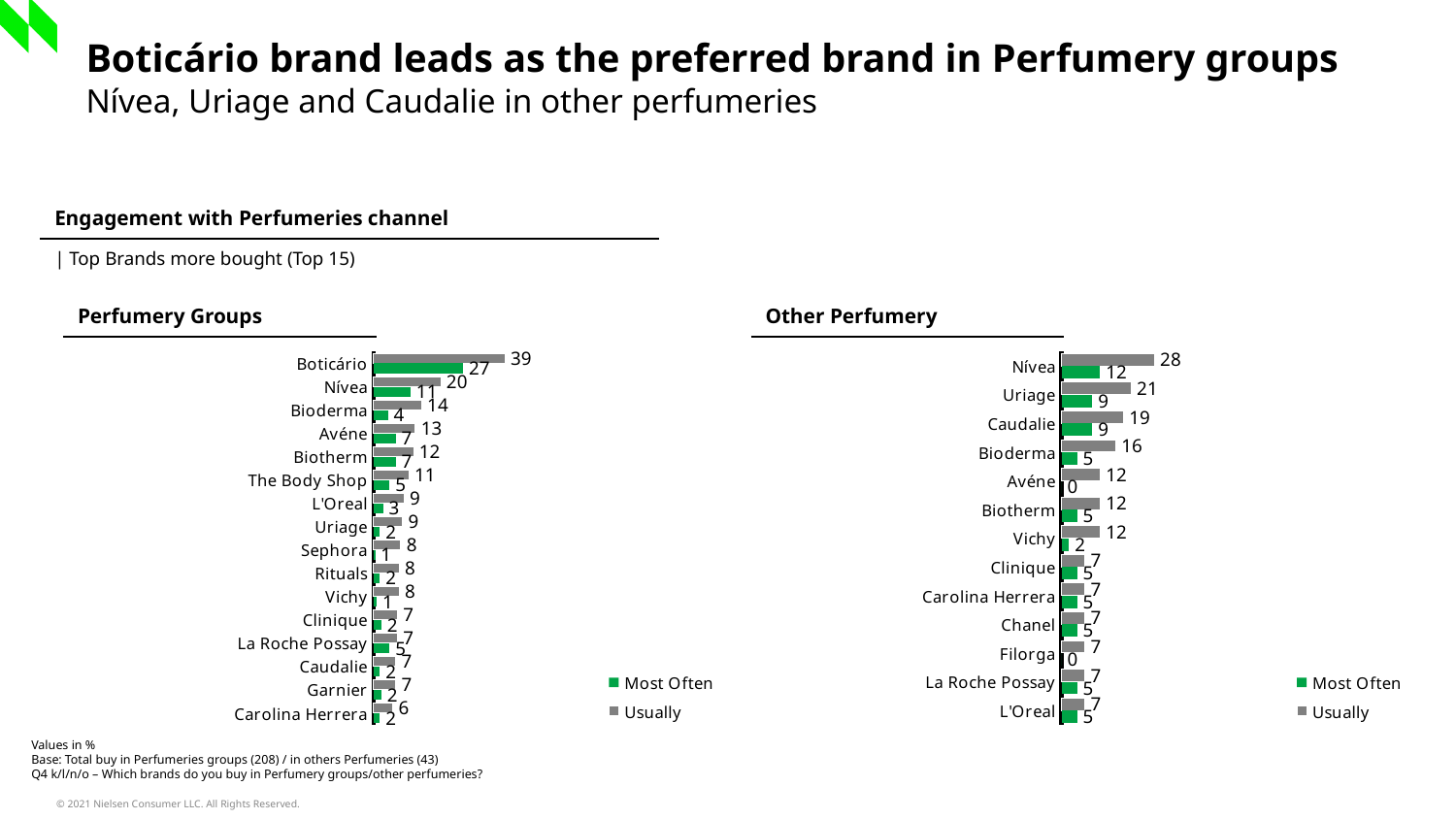
In the Perfumery Groups chart, what is the Usually value for Boticário? 39 In the Perfumery Groups chart, what is the difference between the Usually and Most Often values for Boticário? 12 In the Other Perfumery chart, what is the Usually value for Uriage? 21 In the Other Perfumery chart, what is the difference between the Usually values for Nívea and Caudalie? 9 In the Other Perfumery chart, which brand has the highest Usually value? Nívea In the Perfumery Groups chart, which brand has the lowest Usually value? Carolina Herrera How many series does the legend of the Perfumery Groups chart list? 2 How many brands are shown in the Other Perfumery chart? 13 What type of chart is the Other Perfumery chart? Bar chart In the Perfumery Groups chart, which is larger: the Usually value for Bioderma or the Usually value for Avéne? Bioderma In the Perfumery Groups chart, what is the Most Often value for Nívea? 11 In the Other Perfumery chart, what is the Most Often value for Avéne? 0